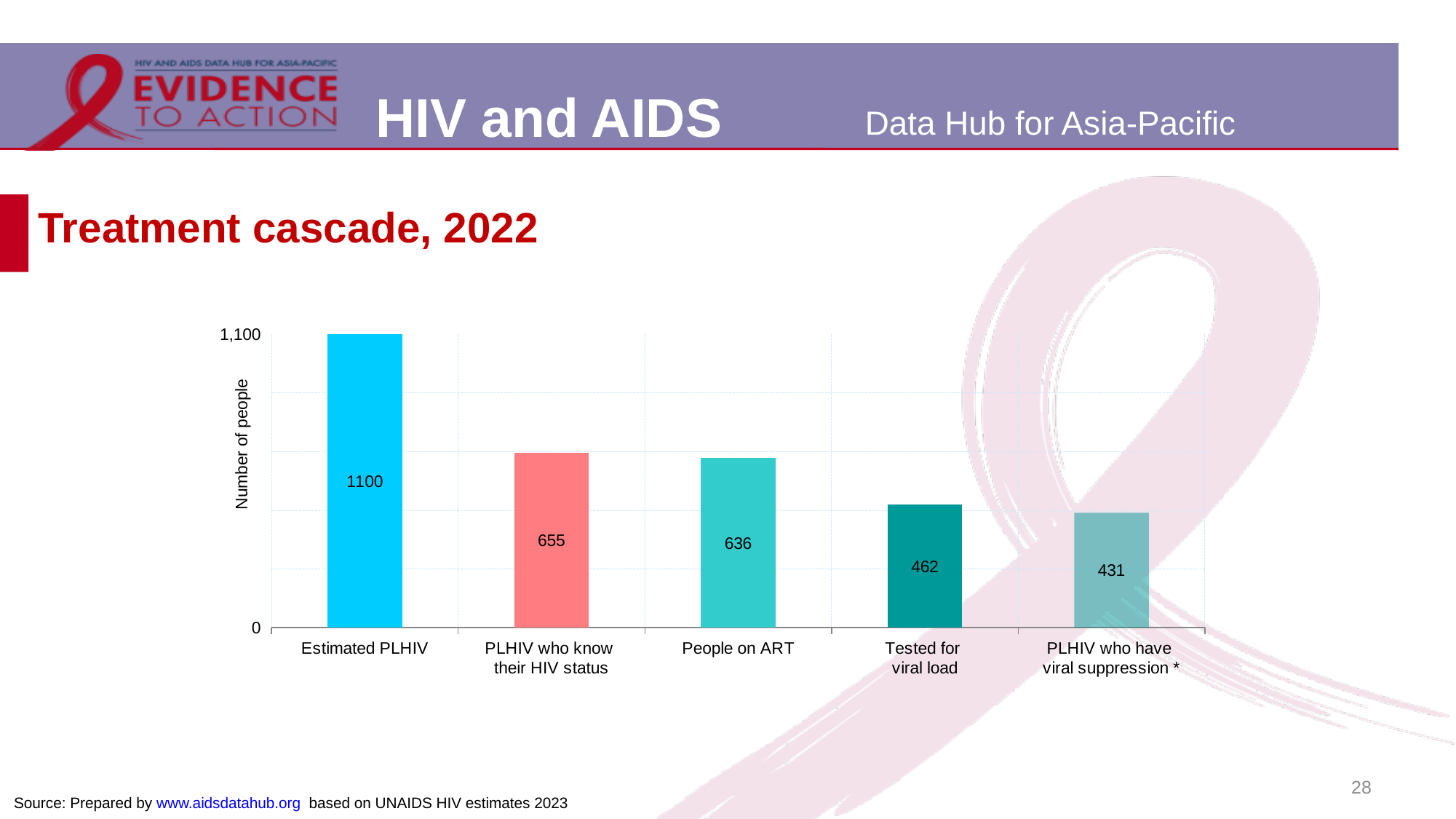
How many categories are shown on the x axis? 5 Which category has the lowest value? PLHIV who have viral suppression * What is the value for Estimated PLHIV? 1100 What is the value for PLHIV who have viral suppression *? 431 What is the value for People on ART? 636 What kind of chart is shown on the slide? Bar chart Which is larger: Tested for viral load or PLHIV who have viral suppression *? Tested for viral load What is the title of the chart? Treatment cascade, 2022 What is the value for PLHIV who know their HIV status? 655 Which category has the highest value? Estimated PLHIV What is the difference between Estimated PLHIV and People on ART? 464 What is the value for Tested for viral load? 462